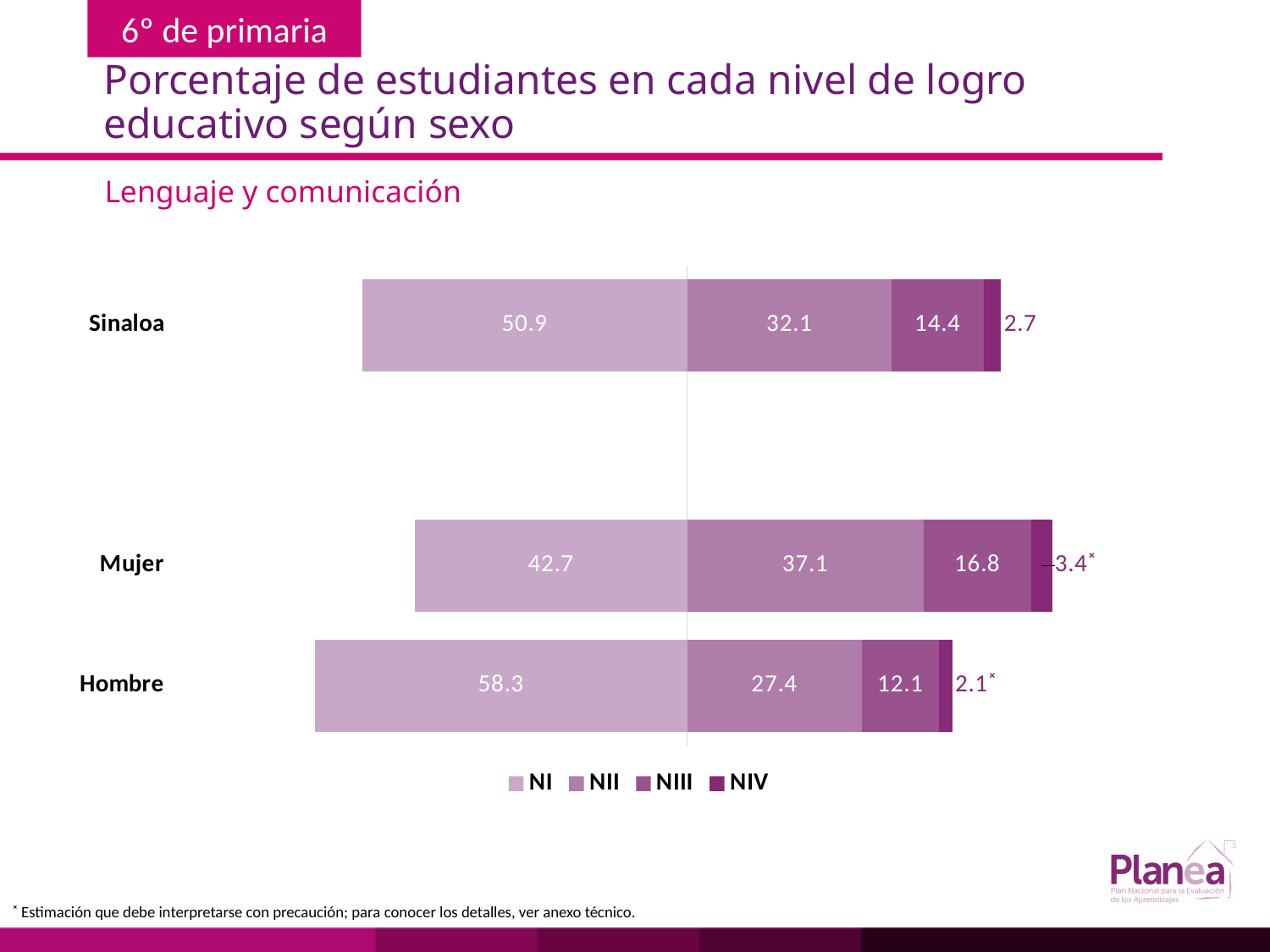
How many series does the legend list? 4 What kind of chart is shown on the slide? Stacked bar chart Which is larger, the NII value for Mujer or the NII value for Sinaloa? Mujer What is the NIV value for Hombre? 2.1 Which category has the highest NI value? Hombre What is the total of the stacked bar for Mujer? 100.0 What percentage of Sinaloa students are at level NI in Lenguaje y comunicación? 50.9 How many categories are shown on the chart? 3 What is the NIII value for Mujer? 16.8 What is the difference between the NI values for Hombre and Mujer? 15.6 Which category has the lowest NIII value? Hombre What is the NII value for Mujer? 37.1